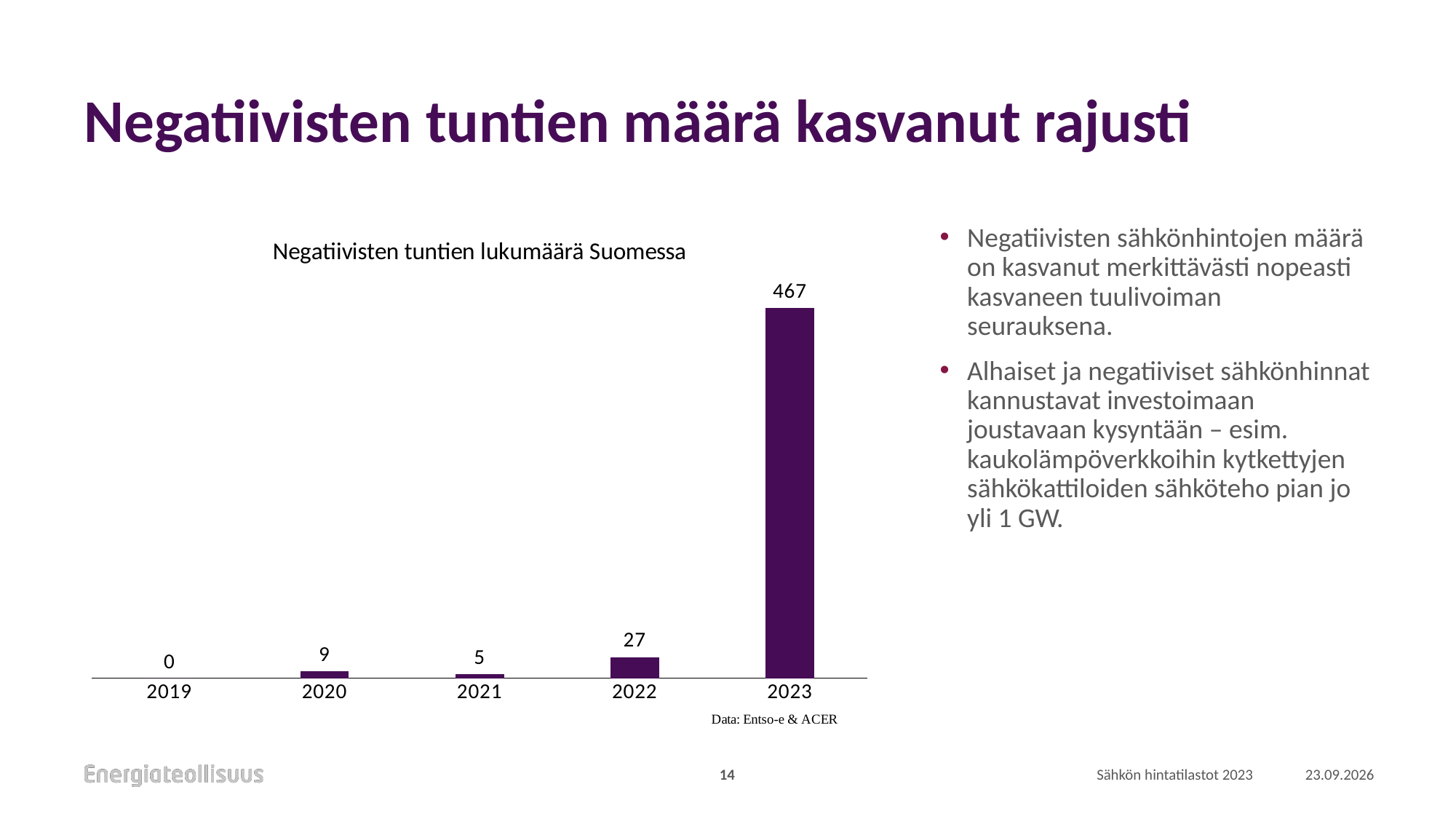
What is the value for 2019? 0 What is the value for 2020? 9 What is the value for 2023? 467 Which is larger, the value for 2020 or the value for 2021? 2020 Which year has the highest value? 2023 How many years are shown on the x axis? 5 What is the title of the chart? Negatiivisten tuntien lukumäärä Suomessa Do the values generally rise or fall from 2021 to 2023? rise What is the difference between the values for 2023 and 2022? 440 Which year has the lowest value? 2019 What kind of chart is this? bar chart What is the value for 2022? 27